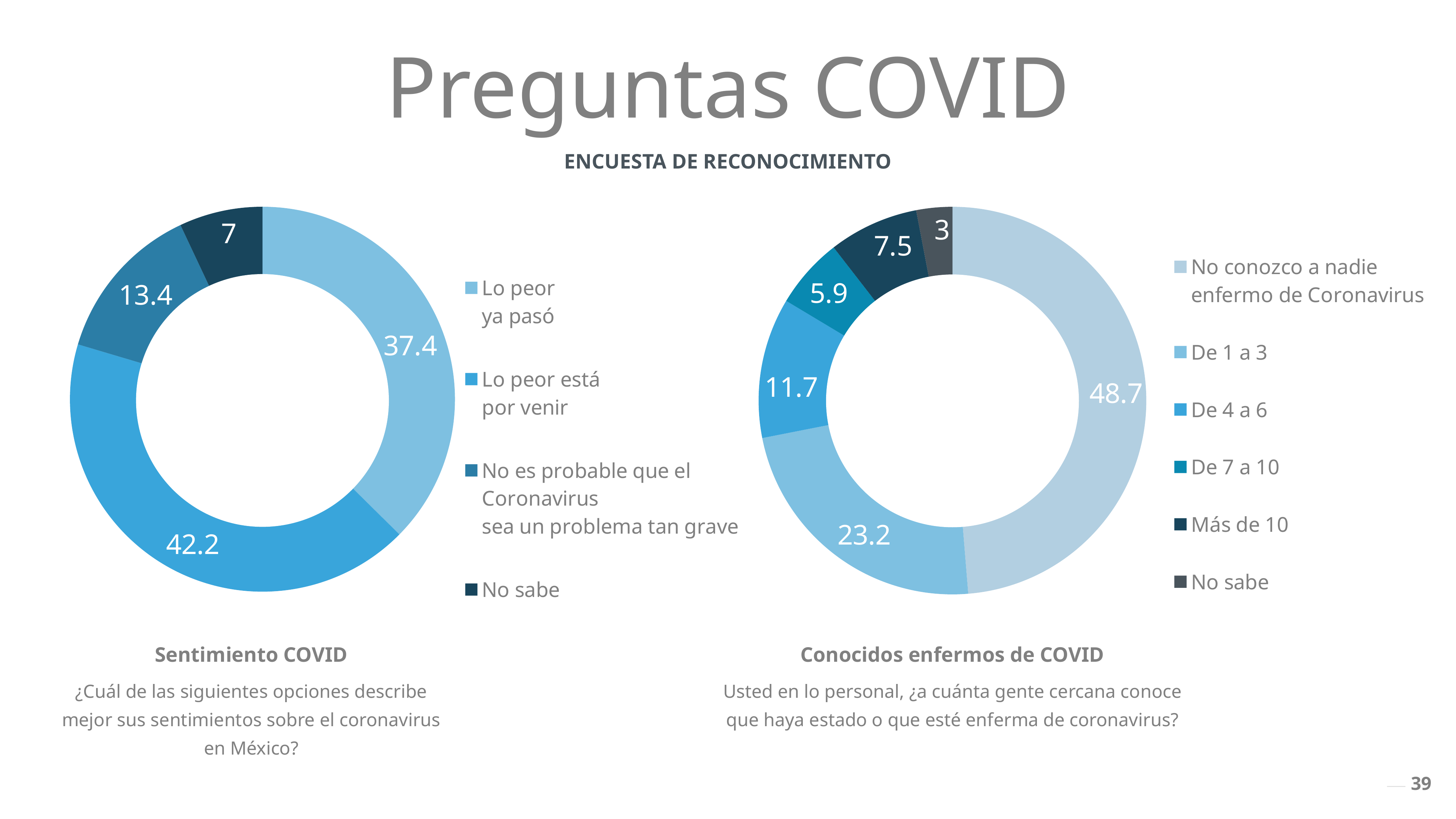
In the 'Sentimiento COVID' chart, what is the value for 'No sabe'? 7 In the 'Sentimiento COVID' chart, which category has the largest value? Lo peor está por venir In the 'Sentimiento COVID' chart, how many categories are shown? 4 In the 'Conocidos enfermos de COVID' chart, how many categories does the legend list? 6 In the 'Conocidos enfermos de COVID' chart, which category has the largest value? No conozco a nadie enfermo de Coronavirus What type of chart is the 'Conocidos enfermos de COVID' chart? Doughnut chart In the 'Sentimiento COVID' chart, what is the value for 'Lo peor está por venir'? 42.2 In the 'Conocidos enfermos de COVID' chart, what is the value for 'Más de 10'? 7.5 In the 'Conocidos enfermos de COVID' chart, which is larger, 'De 4 a 6' or 'De 7 a 10'? De 4 a 6 In the 'Conocidos enfermos de COVID' chart, what is the value for 'De 1 a 3'? 23.2 In the 'Sentimiento COVID' chart, what is the difference between 'Lo peor está por venir' and 'Lo peor ya pasó'? 4.8 In the 'Sentimiento COVID' chart, which category has the smallest value? No sabe